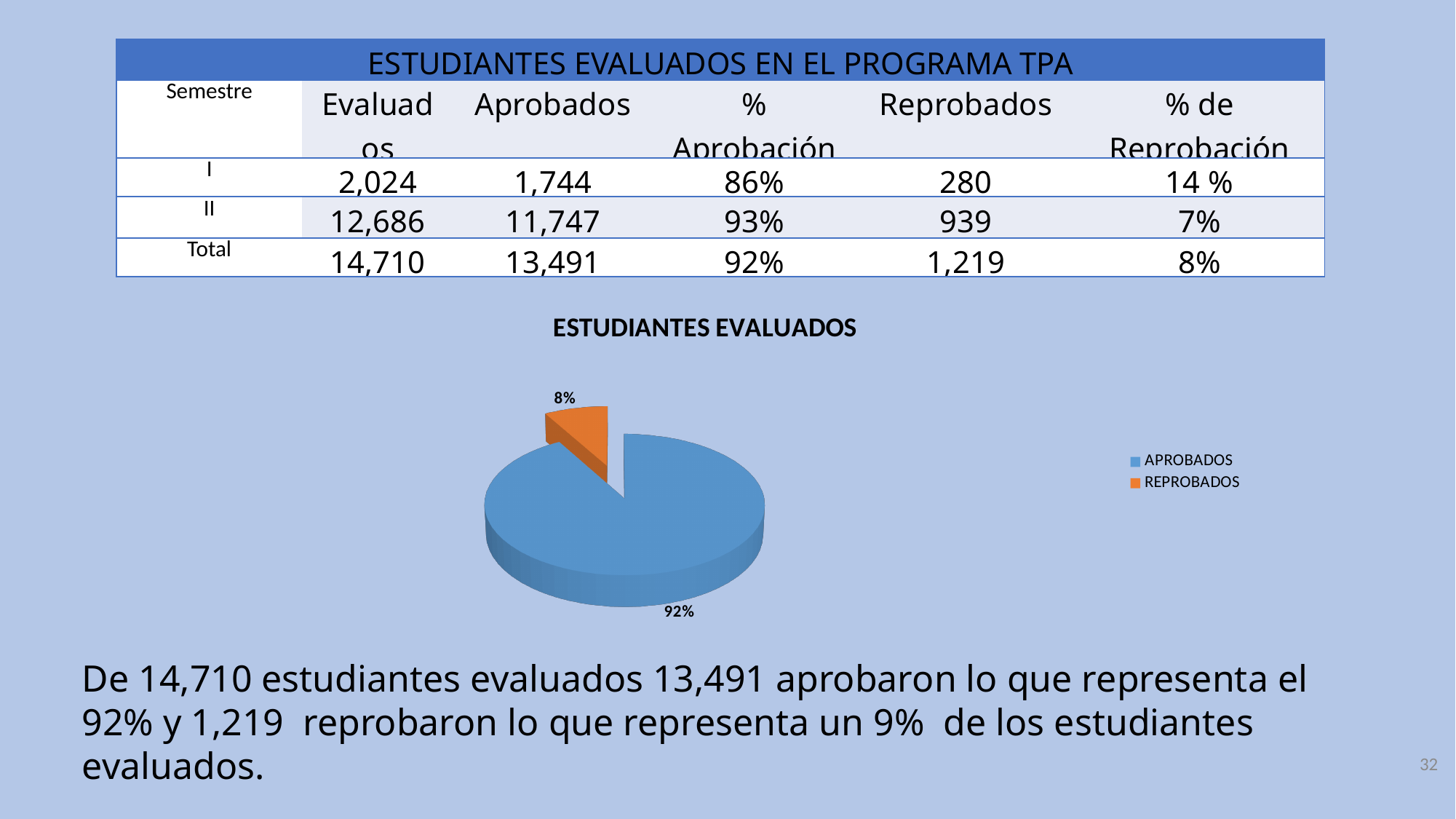
How many entries does the chart legend list? 2 Which is larger in the pie chart, APROBADOS or REPROBADOS? APROBADOS How many slices does the pie chart have? 2 What share of the pie does REPROBADOS represent? 8% What is the difference in percentage points between the APROBADOS and REPROBADOS slices? 84 What colour is the REPROBADOS slice in the pie chart? orange What kind of chart is shown on the slide? pie chart What share of the pie does APROBADOS represent? 92% Which slice of the pie chart is the smallest? REPROBADOS Which slice of the pie chart is the largest? APROBADOS What is the title of the chart? ESTUDIANTES EVALUADOS